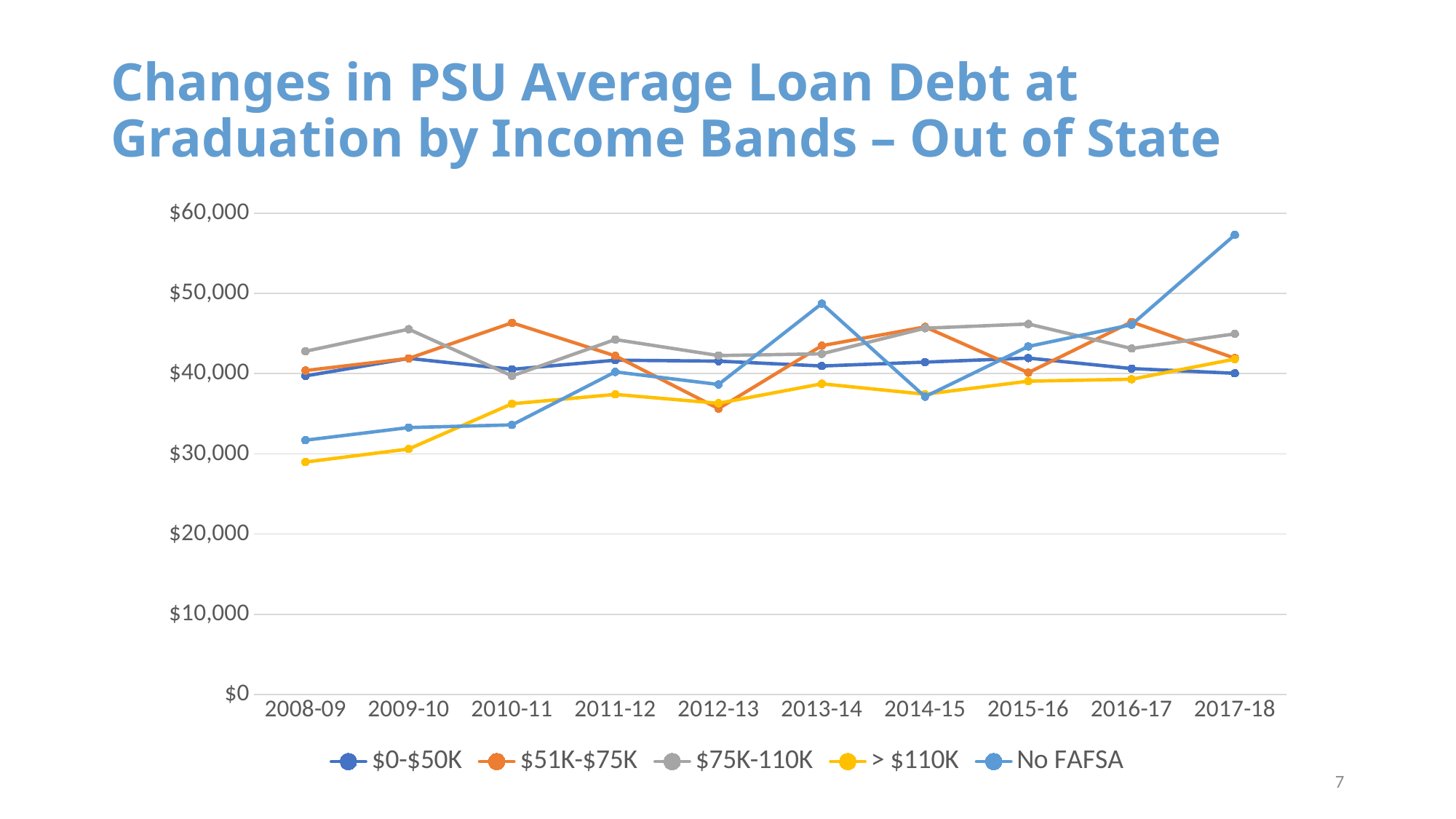
What kind of chart is shown on the slide? line chart How many series does the legend list? 5 Which series has the highest value in 2017-18? No FAFSA What is the title of the chart on the slide? Changes in PSU Average Loan Debt at Graduation by Income Bands – Out of State In 2008-09, which is larger: the value for $75K-110K or the value for > $110K? $75K-110K Is the value for No FAFSA in 2013-14 greater or less than $40,000? greater How many academic years are shown on the x axis? 10 In which year does the > $110K series have its lowest value? 2008-09 Does the > $110K series rise or fall overall from 2008-09 to 2017-18? rise Is the value for > $110K in 2008-09 greater or less than $30,000? less Is the value for No FAFSA in 2017-18 greater or less than $50,000? greater